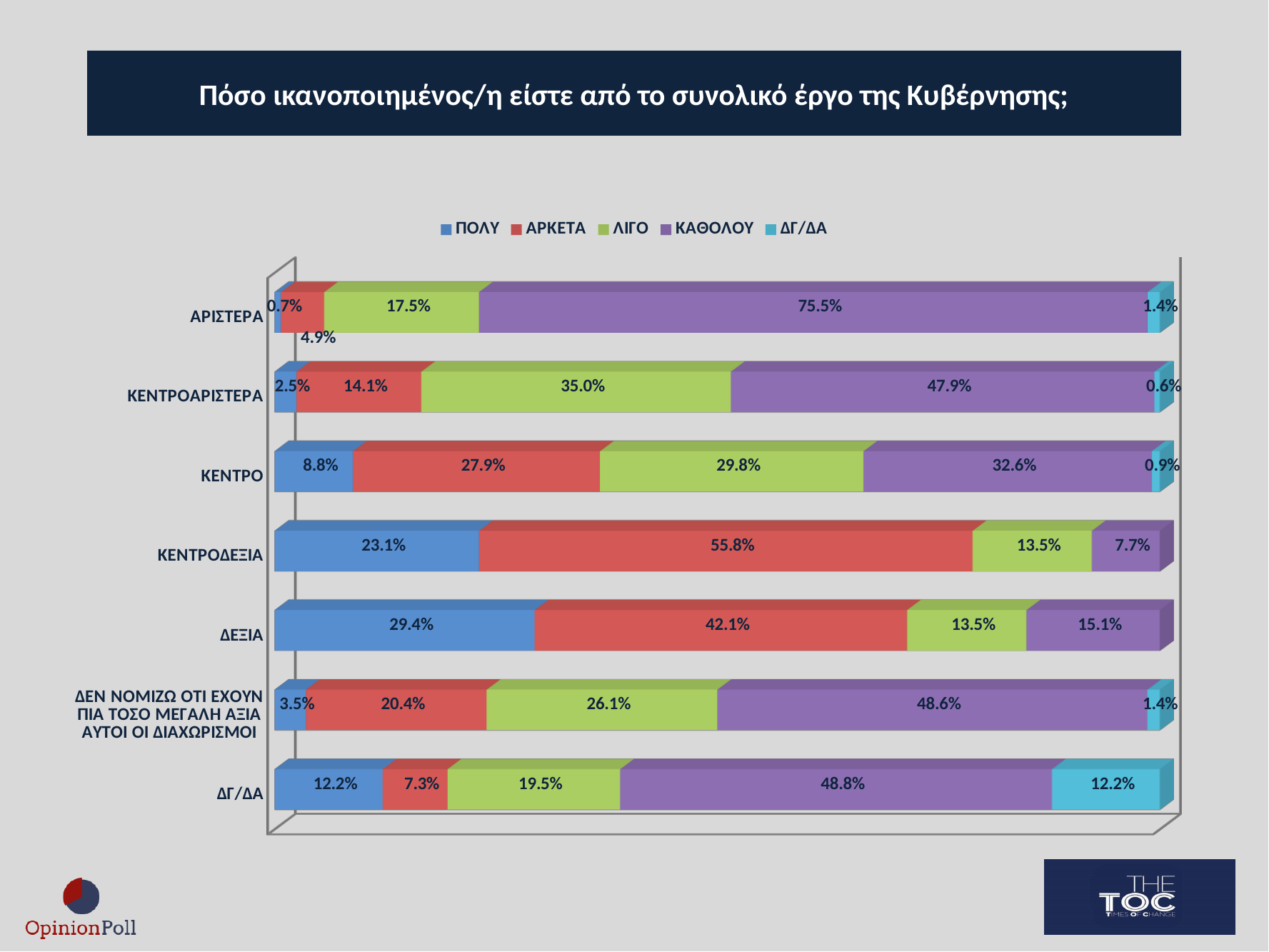
What is the ΑΡΚΕΤΑ value for ΚΕΝΤΡΟΔΕΞΙΑ? 55.8% What is the ΛΙΓΟ value for ΚΕΝΤΡΟΑΡΙΣΤΕΡΑ? 35.0% What is the ΠΟΛΥ value for ΔΕΞΙΑ? 29.4% What is the difference between the ΚΑΘΟΛΟΥ values for ΑΡΙΣΤΕΡΑ and ΚΕΝΤΡΟΑΡΙΣΤΕΡΑ? 27.6 percentage points How many series does the legend list? 5 How many categories are plotted on the chart? 7 What colour represents the ΚΑΘΟΛΟΥ series in the legend? Purple What is the ΚΑΘΟΛΟΥ value for ΑΡΙΣΤΕΡΑ? 75.5% Which category has the lowest ΠΟΛΥ value? ΑΡΙΣΤΕΡΑ What type of chart is shown on the slide? Stacked bar chart Which is larger: the ΑΡΚΕΤΑ value for ΚΕΝΤΡΟ or the ΑΡΚΕΤΑ value for ΔΕΞΙΑ? ΔΕΞΙΑ Which category has the highest ΠΟΛΥ value? ΔΕΞΙΑ